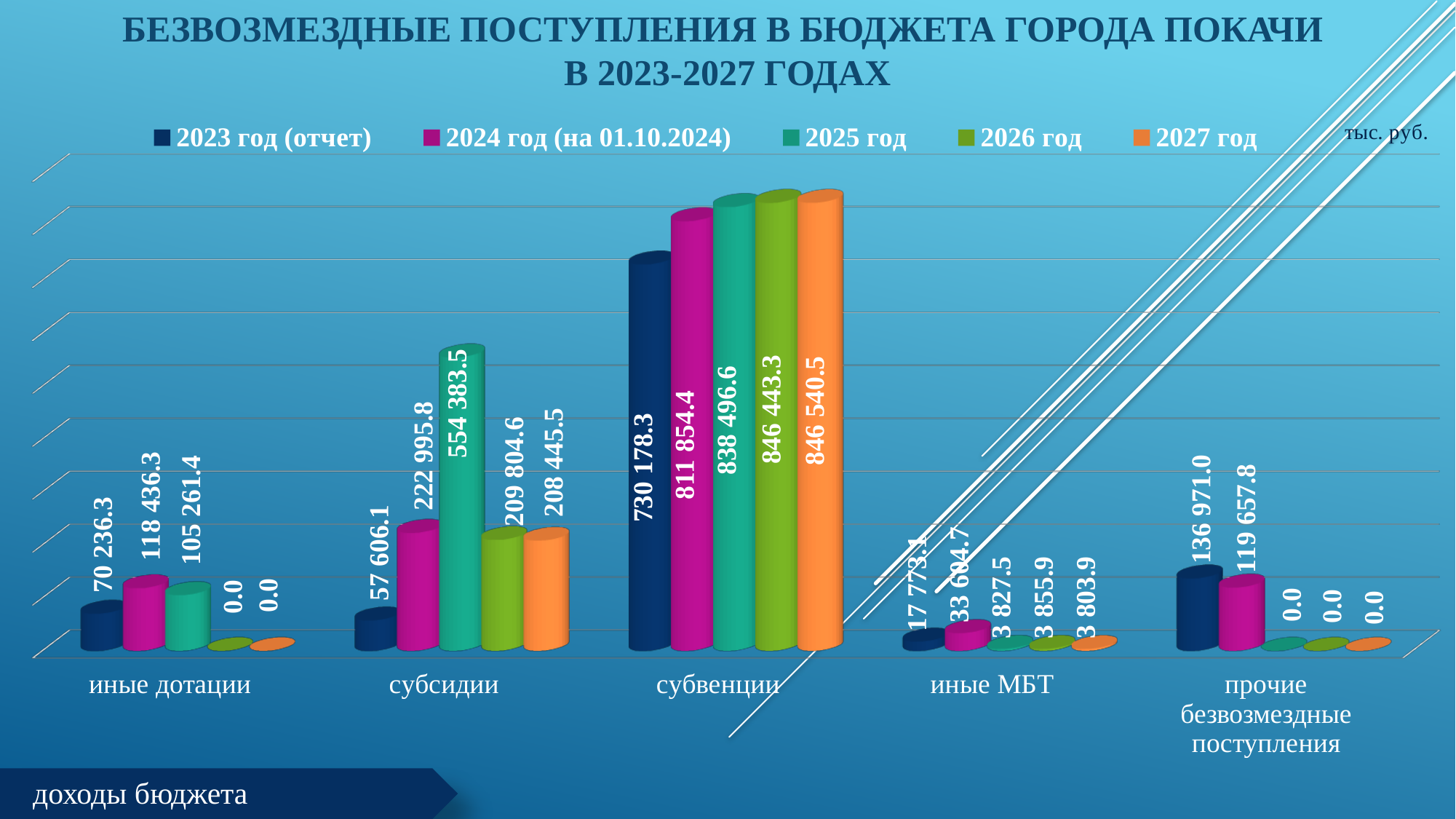
In which year is the value for субсидии the highest? 2025 год What kind of chart is shown on the slide? bar chart How many series does the legend list? 5 What is the value for иные дотации in 2023 год (отчет)? 70 236.3 Which category has the highest value in 2026 год? субвенции How many categories are shown on the x axis? 5 What unit is indicated for the values on the chart? тыс. руб. Which is larger for иные дотации: the 2024 год (на 01.10.2024) value or the 2025 год value? 2024 год (на 01.10.2024) What is the value for прочие безвозмездные поступления in 2027 год? 0.0 What is the value for субвенции in 2025 год? 838 496.6 What is the value for субсидии in 2024 год (на 01.10.2024)? 222 995.8 What is the difference between the 2025 год and 2023 год (отчет) values for субсидии? 496 777.4